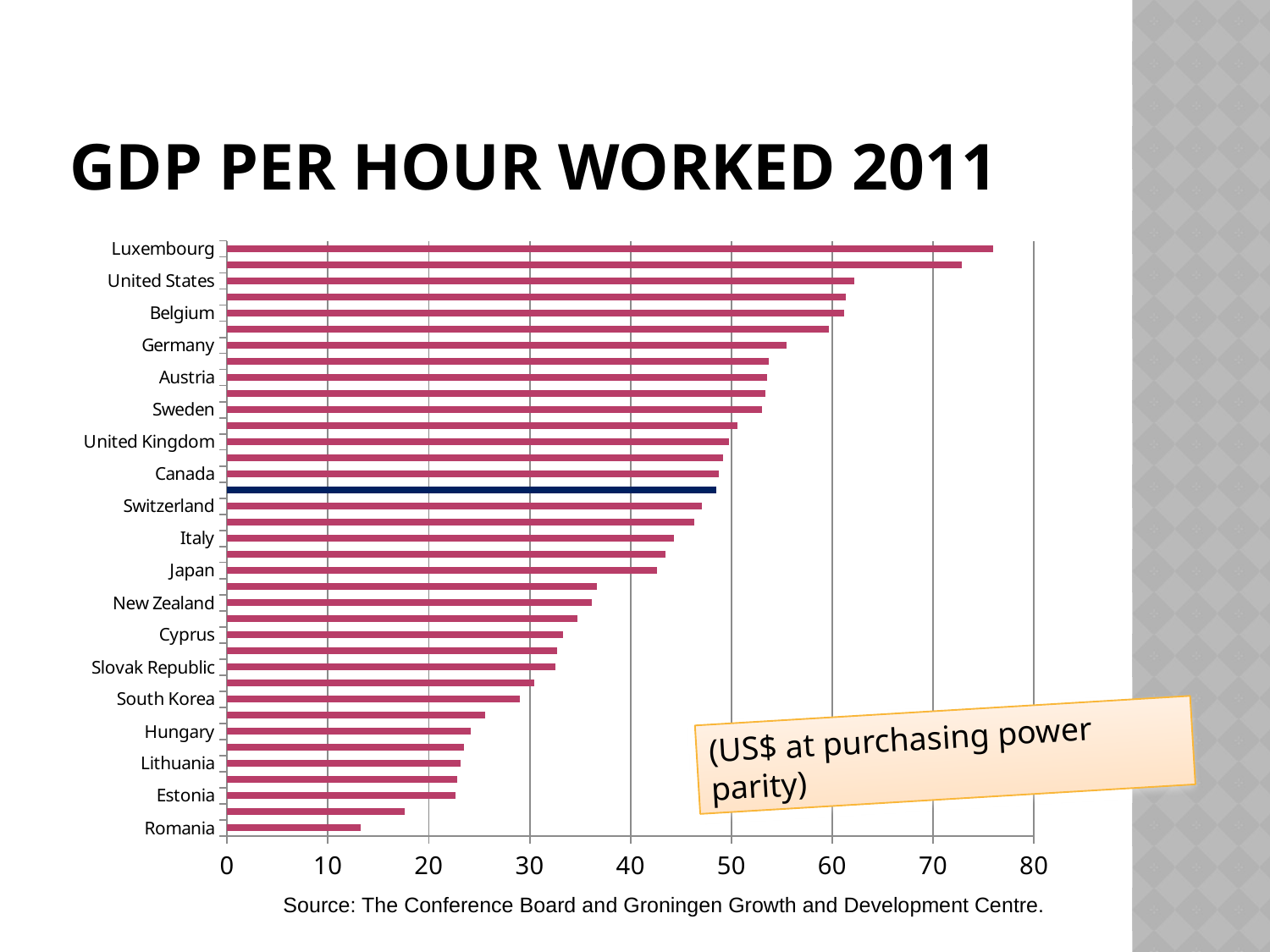
Is the value for South Korea greater or less than 30? less Which country has the lowest GDP per hour worked in the chart? Romania What is the title of the chart? GDP PER HOUR WORKED 2011 In what unit are the values expressed, according to the callout on the slide? US$ at purchasing power parity Which has a higher GDP per hour worked, the United States or Italy? United States Is the value for Japan greater or less than 40? greater Is the value for Luxembourg greater or less than 70? greater Which country has the highest GDP per hour worked in the chart? Luxembourg What kind of chart is shown on the slide? bar chart Which has a lower GDP per hour worked, Estonia or Cyprus? Estonia